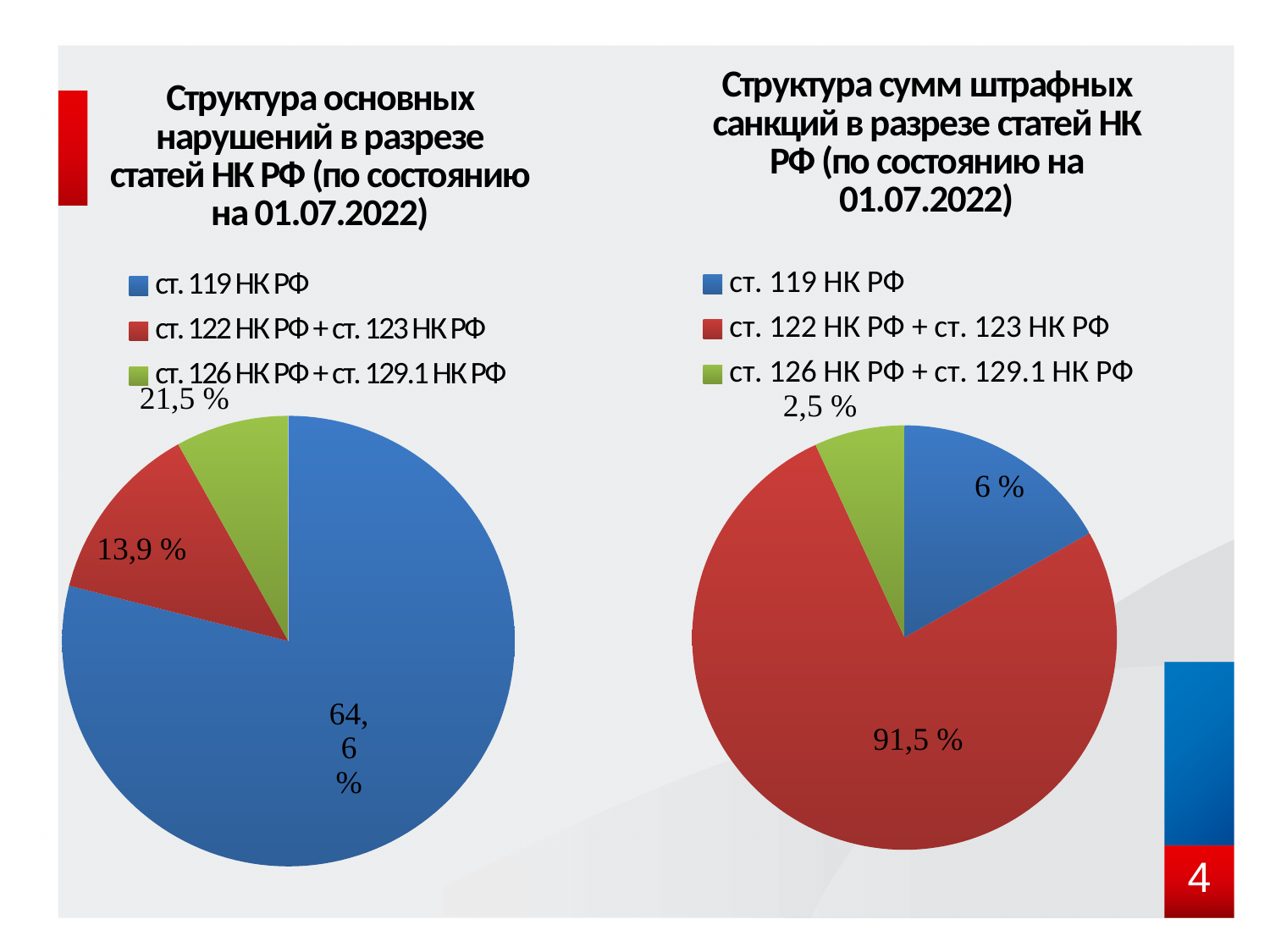
In the right chart (Структура сумм штрафных санкций), which category has the largest slice? ст. 122 НК РФ + ст. 123 НК РФ In the right chart (Структура сумм штрафных санкций), what share is shown for ст. 119 НК РФ? 6 % In the right chart (Структура сумм штрафных санкций), what share is shown for ст. 126 НК РФ + ст. 129.1 НК РФ? 2,5 % In the left chart (Структура основных нарушений), what share is shown for ст. 119 НК РФ? 64,6 % What type of chart is used on the left side of the slide? Pie chart In the right chart (Структура сумм штрафных санкций), which is larger: the share of ст. 119 НК РФ or the share of ст. 126 НК РФ + ст. 129.1 НК РФ? ст. 119 НК РФ In the right chart (Структура сумм штрафных санкций), what share is shown for ст. 122 НК РФ + ст. 123 НК РФ? 91,5 % How many categories does the legend of the right chart (Структура сумм штрафных санкций) list? 3 In the left chart (Структура основных нарушений), which category has the largest slice? ст. 119 НК РФ In the right chart (Структура сумм штрафных санкций), what is the difference between the shares of ст. 122 НК РФ + ст. 123 НК РФ and ст. 119 НК РФ? 85,5 % In the right chart (Структура сумм штрафных санкций), which category has the smallest slice? ст. 126 НК РФ + ст. 129.1 НК РФ In the left chart (Структура основных нарушений), what colour represents ст. 119 НК РФ? Blue